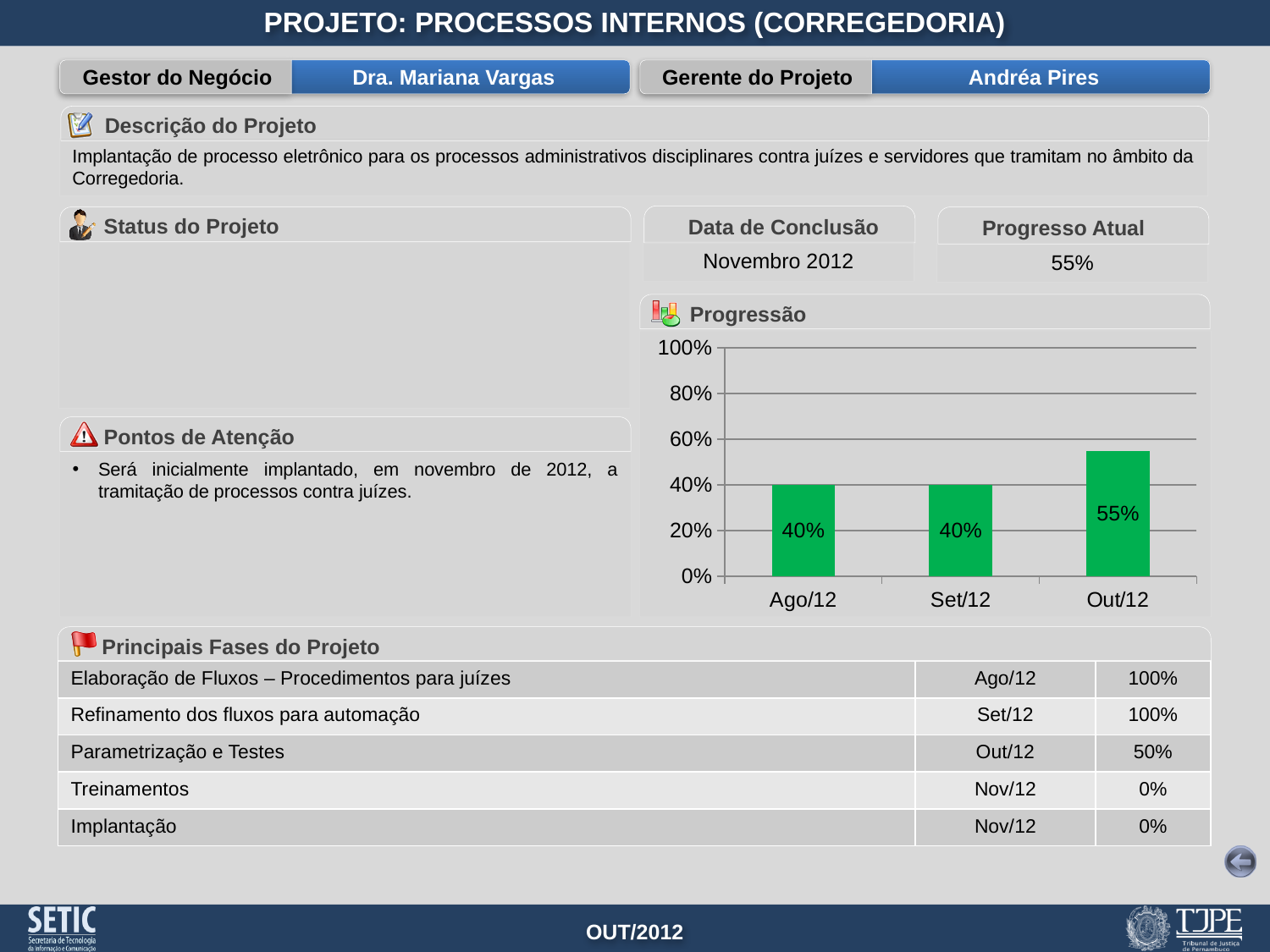
What is the difference between the values for Out/12 and Set/12 in the Progressão chart? 15% How many months are shown on the x axis of the Progressão chart? 3 What colour are the bars in the Progressão chart? green Which is larger in the Progressão chart, the value for Ago/12 or the value for Out/12? Out/12 What is the highest value shown on the y axis of the Progressão chart? 100% Do the values in the Progressão chart rise or fall from Set/12 to Out/12? rise Is the value for Out/12 in the Progressão chart greater or less than 60%? less Which month has the highest value in the Progressão chart? Out/12 What is the value for Set/12 in the Progressão chart? 40% What kind of chart is the Progressão chart? bar chart What is the value for Out/12 in the Progressão chart? 55% What is the value for Ago/12 in the Progressão chart? 40%